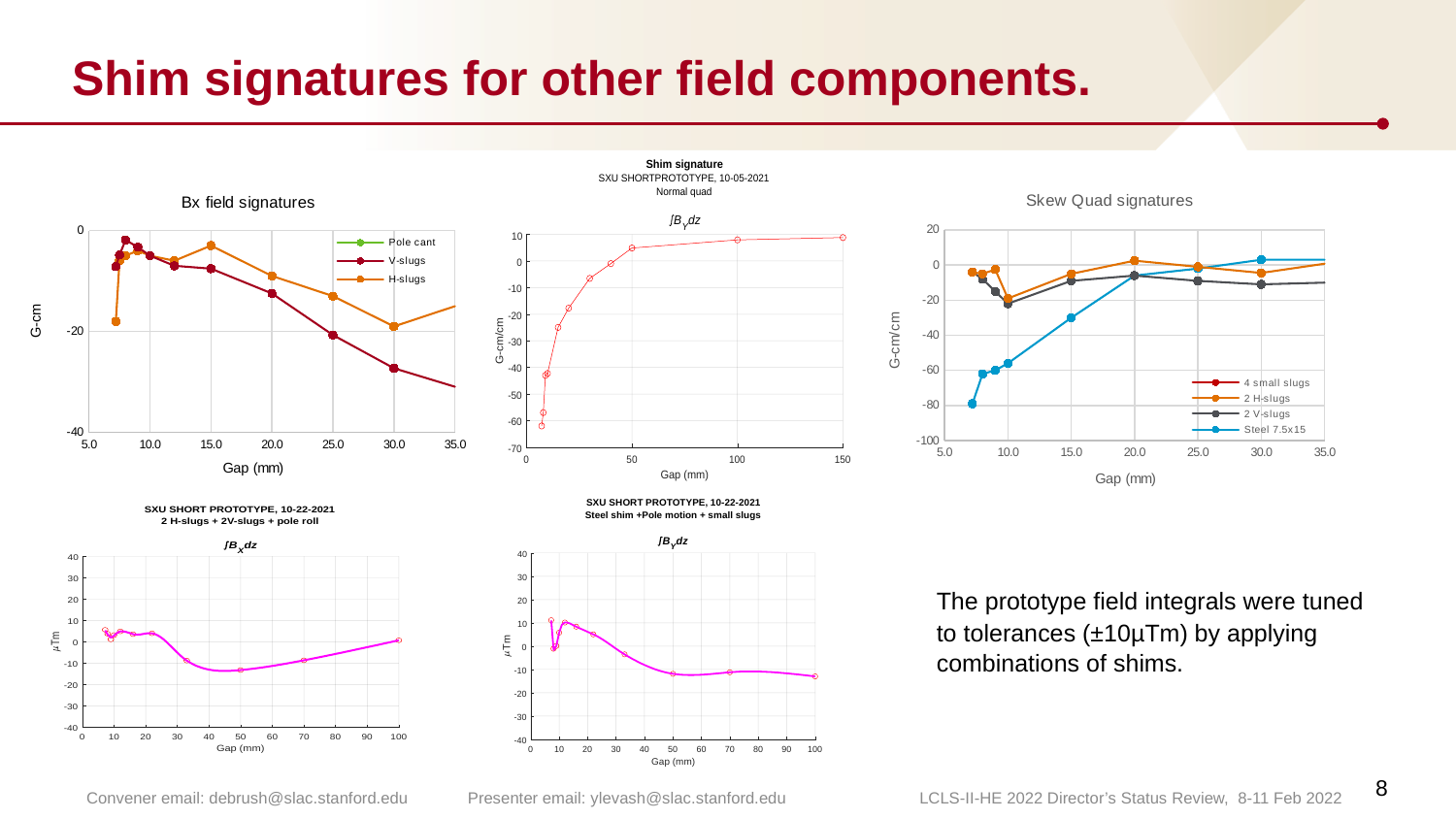
In the 'Skew Quad signatures' chart, does the Steel 7.5x15 series rise or fall as the gap increases from 7 to 20 mm? rise In the 'Skew Quad signatures' chart, how many series does the legend list? 4 What kind of chart is the 'Bx field signatures' chart? line chart In the 'Skew Quad signatures' chart, is the Steel 7.5x15 value at the smallest gap (about 7 mm) greater or less than -60? less In the bottom-middle chart ('Steel shim + Pole motion + small slugs'), is the ∫By dz value at a gap of 100 mm greater or less than 0? less In the bottom-left chart ('2 H-slugs + 2V-slugs + pole roll'), is the ∫Bx dz value at a gap of 50 mm greater or less than 0? less In the 'Shim signature' Normal quad chart (top middle), does the ∫By dz value rise or fall as the gap increases? rise In the 'Bx field signatures' chart, does the V-slugs series rise or fall as the gap increases from 10.0 to 35.0 mm? fall What unit is shown on the y axis of the bottom-left chart ('2 H-slugs + 2V-slugs + pole roll')? µTm In the 'Bx field signatures' chart, how many series does the legend list? 3